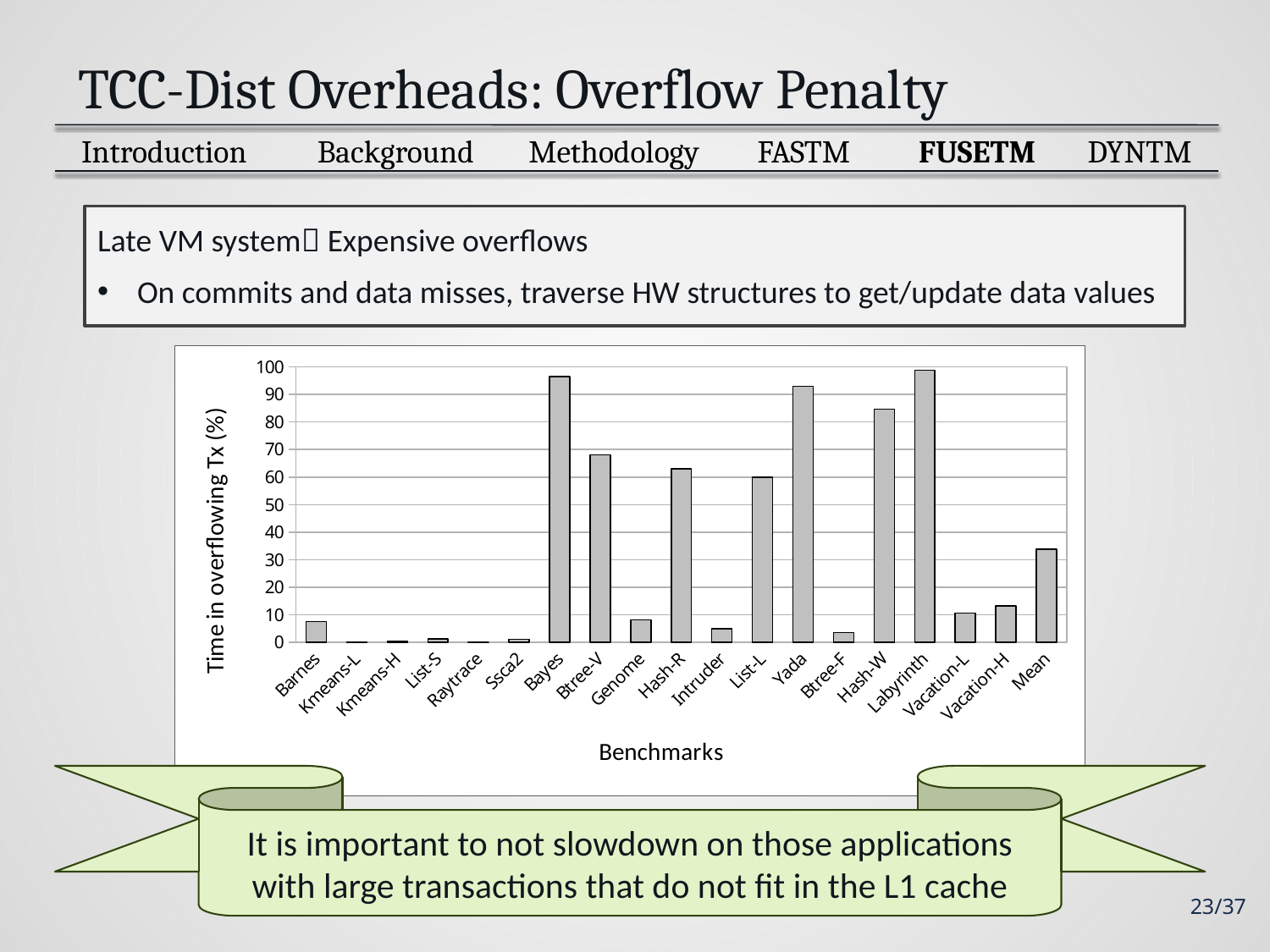
Which has a higher time in overflowing transactions, Hash-W or Hash-R? Hash-W Is the value for Bayes greater or less than 90? greater Is the value for Vacation-H greater or less than 20? less What is the label of the y axis? Time in overflowing Tx (%) Which benchmark has the highest time in overflowing transactions? Labyrinth Is the value for Mean greater or less than 30? greater Which has a higher time in overflowing transactions, Bayes or Btree-V? Bayes What kind of chart is shown on the slide? bar chart How many benchmark categories are plotted along the x axis? 19 What is the label of the x axis? Benchmarks